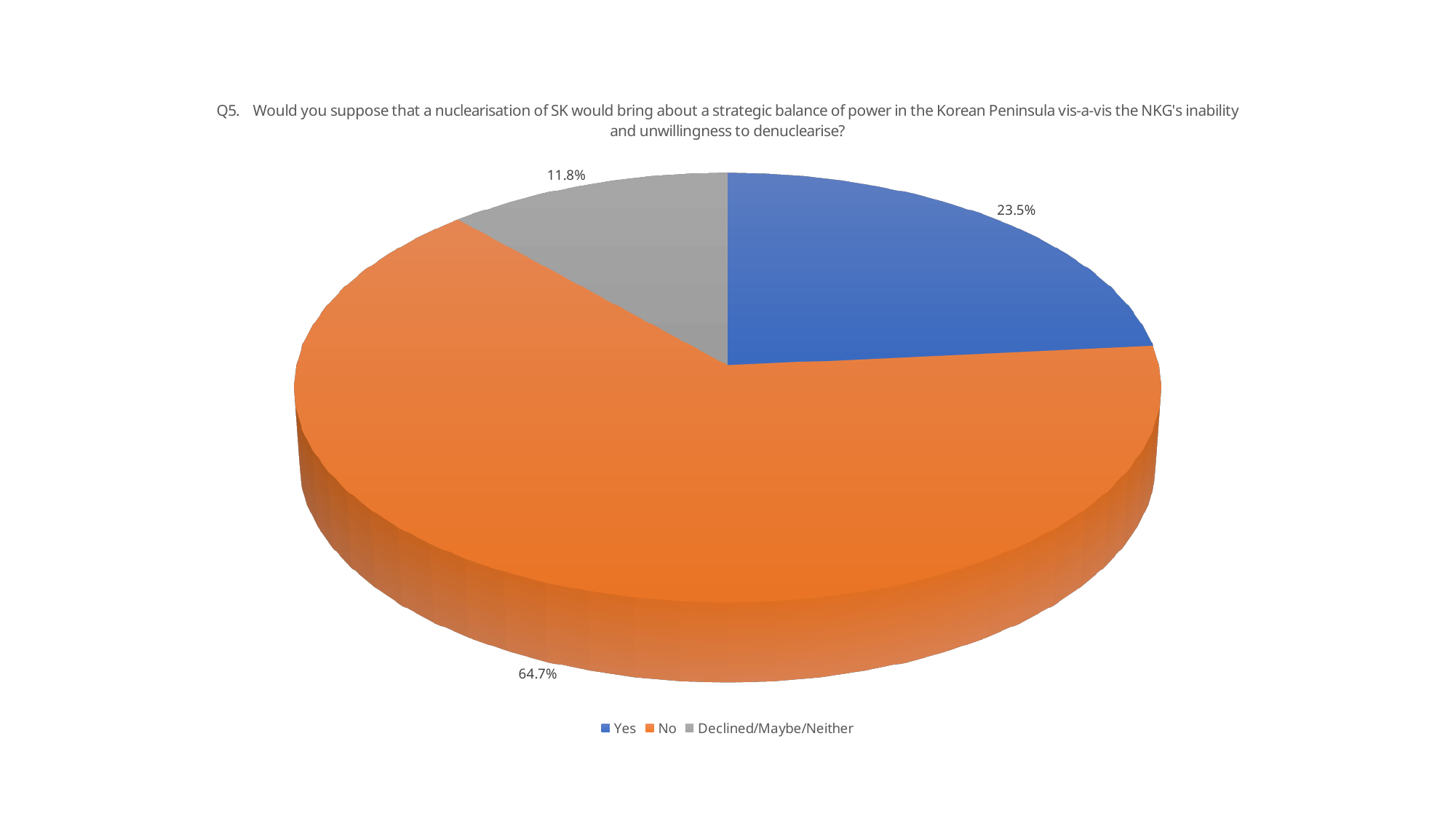
Which response has the smallest slice of the pie? Declined/Maybe/Neither How many slices does the pie chart have? 3 What share of respondents answered "No"? 64.7% What share of respondents answered "Yes"? 23.5% What is the difference in percentage points between the "Yes" and "Declined/Maybe/Neither" slices? 11.7 How many entries does the legend list? 3 What is the difference in percentage points between the "No" and "Yes" slices? 41.2 What share of respondents fall under "Declined/Maybe/Neither"? 11.8% Which is larger, the "Yes" slice or the "Declined/Maybe/Neither" slice? Yes What colour is the "No" slice? Orange Which response has the largest slice of the pie? No What kind of chart is shown on the slide? Pie chart